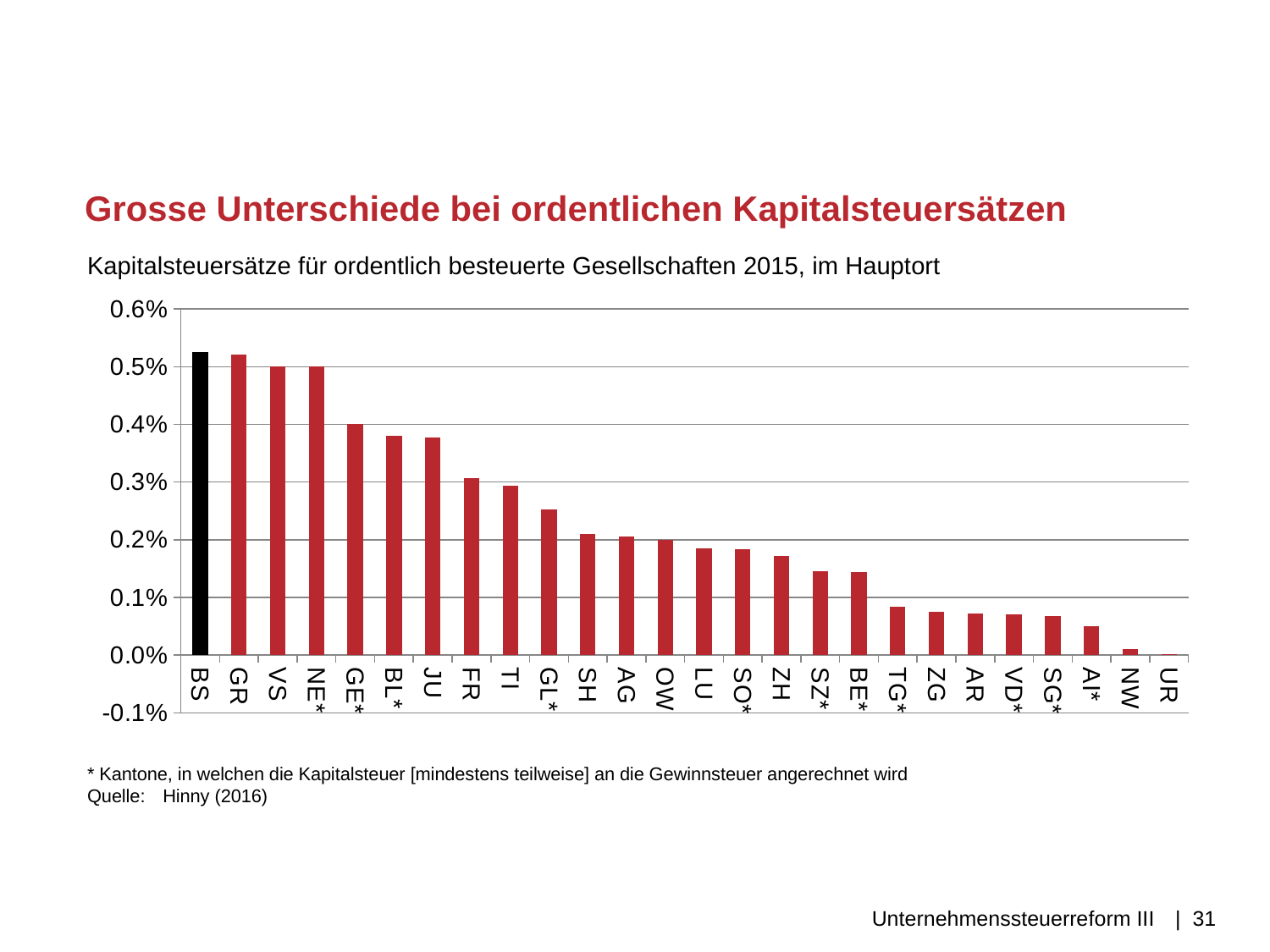
How many cantons are shown on the x axis of the chart? 26 Is the value for BL* greater or less than 0.4%? less Which canton has the lowest capital tax rate in the chart? UR Which has the larger value, JU or FR? JU Is the value for ZH greater or less than 0.2%? less Do the values rise or fall from left to right along the x axis? fall Is the value for TG* greater or less than 0.1%? less Which has the larger value, SH or ZH? SH Which canton's bar is coloured black instead of red? BS What kind of chart is shown on the slide? bar chart